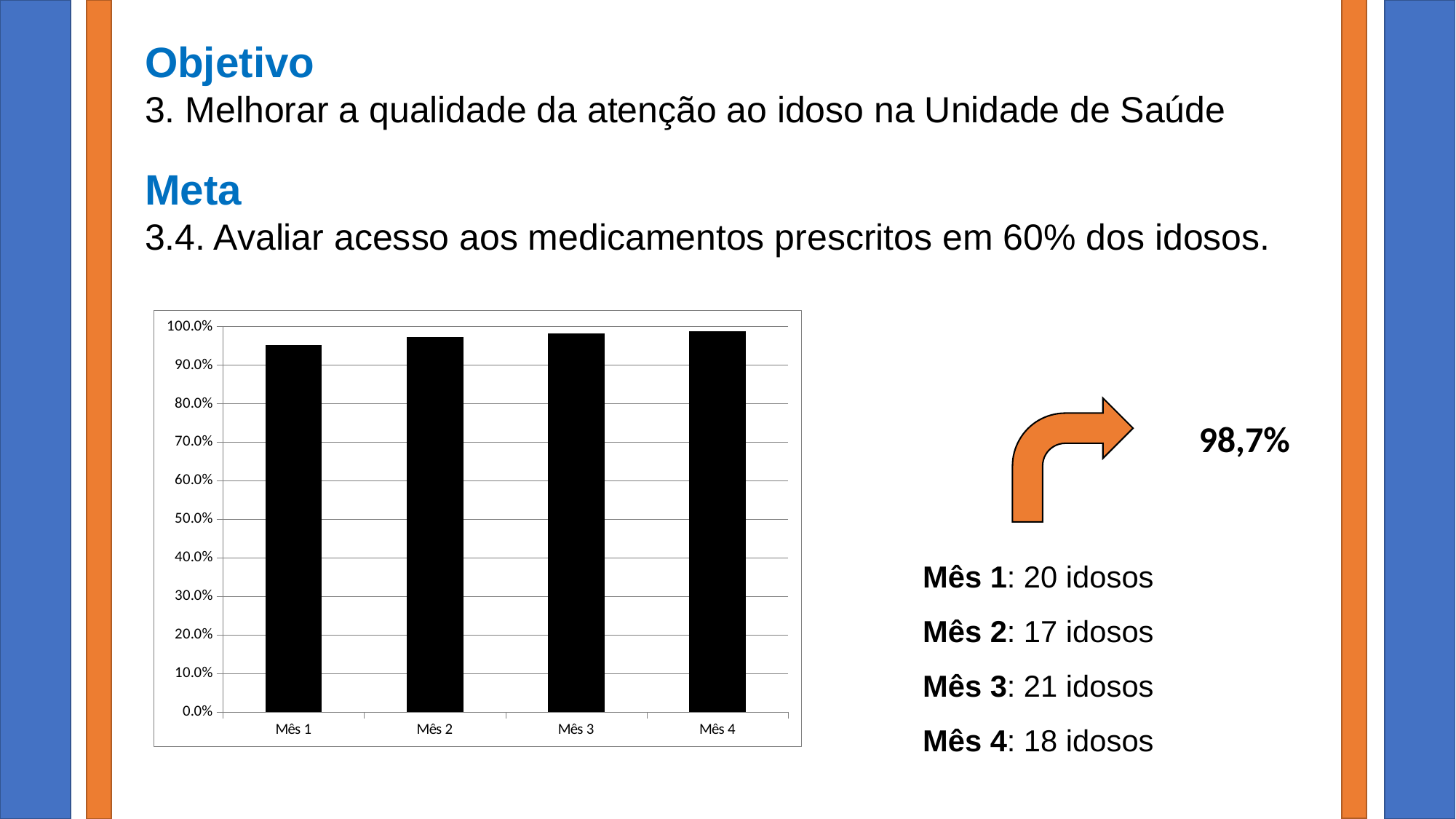
What is the label of the first category on the x axis? Mês 1 Which is larger, the value for Mês 1 or the value for Mês 4? Mês 4 What kind of chart is shown on the slide? bar chart Is the value for Mês 2 greater or less than 100.0%? less Is the value for Mês 3 greater or less than 80.0%? greater How many categories (months) are plotted on the chart? 4 Which is larger, the value for Mês 1 or the value for Mês 3? Mês 3 Do the bar values rise or fall from Mês 1 to Mês 4? rise Is the value for Mês 4 greater or less than 60.0%? greater Which month has the lowest bar on the chart? Mês 1 What is the highest tick value shown on the y axis? 100.0%